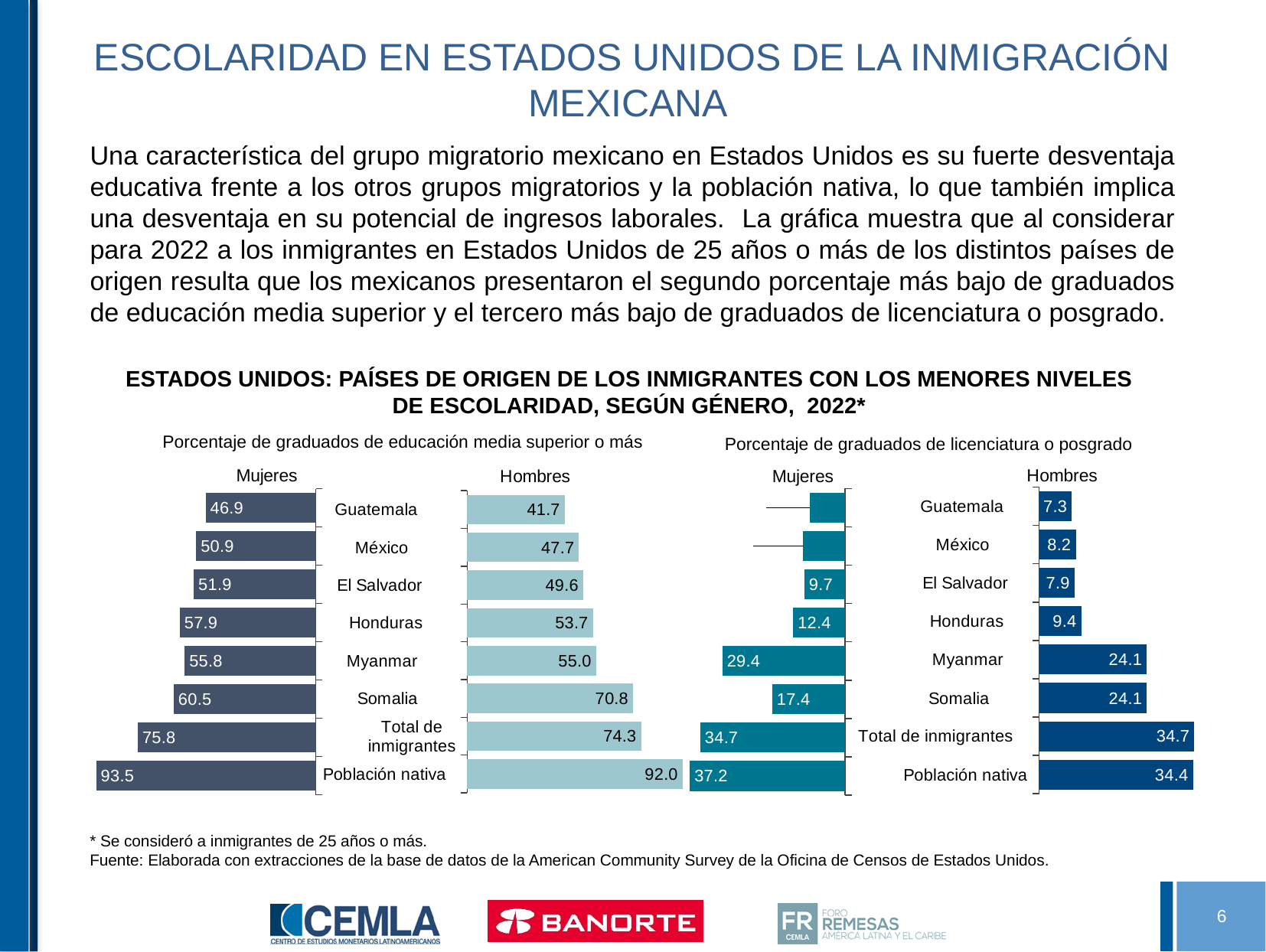
In the 'Porcentaje de graduados de licenciatura o posgrado' chart, what is the value for Myanmar in the Mujeres panel? 29.4 In the 'Porcentaje de graduados de educación media superior o más' chart, which category has the lowest value in the Hombres panel? Guatemala In the 'Porcentaje de graduados de licenciatura o posgrado' chart, what is the value for Honduras in the Hombres panel? 9.4 What kind of chart is used for 'Porcentaje de graduados de licenciatura o posgrado'? Bar chart In the 'Porcentaje de graduados de educación media superior o más' chart, what is the value for México in the Mujeres panel? 50.9 In the 'Porcentaje de graduados de licenciatura o posgrado' chart, which category has the lowest value in the Hombres panel? Guatemala In the 'Porcentaje de graduados de educación media superior o más' chart, which is larger for Honduras: the Mujeres value or the Hombres value? Mujeres How many categories are shown in the 'Porcentaje de graduados de educación media superior o más' chart? 8 In the 'Porcentaje de graduados de educación media superior o más' chart, what is the difference between Población nativa and Total de inmigrantes in the Hombres panel? 17.7 In the 'Porcentaje de graduados de licenciatura o posgrado' chart, which is larger for Somalia: the Mujeres value or the Hombres value? Hombres In the 'Porcentaje de graduados de educación media superior o más' chart, what is the value for Somalia in the Hombres panel? 70.8 In the 'Porcentaje de graduados de educación media superior o más' chart, which category has the highest value in the Mujeres panel? Población nativa